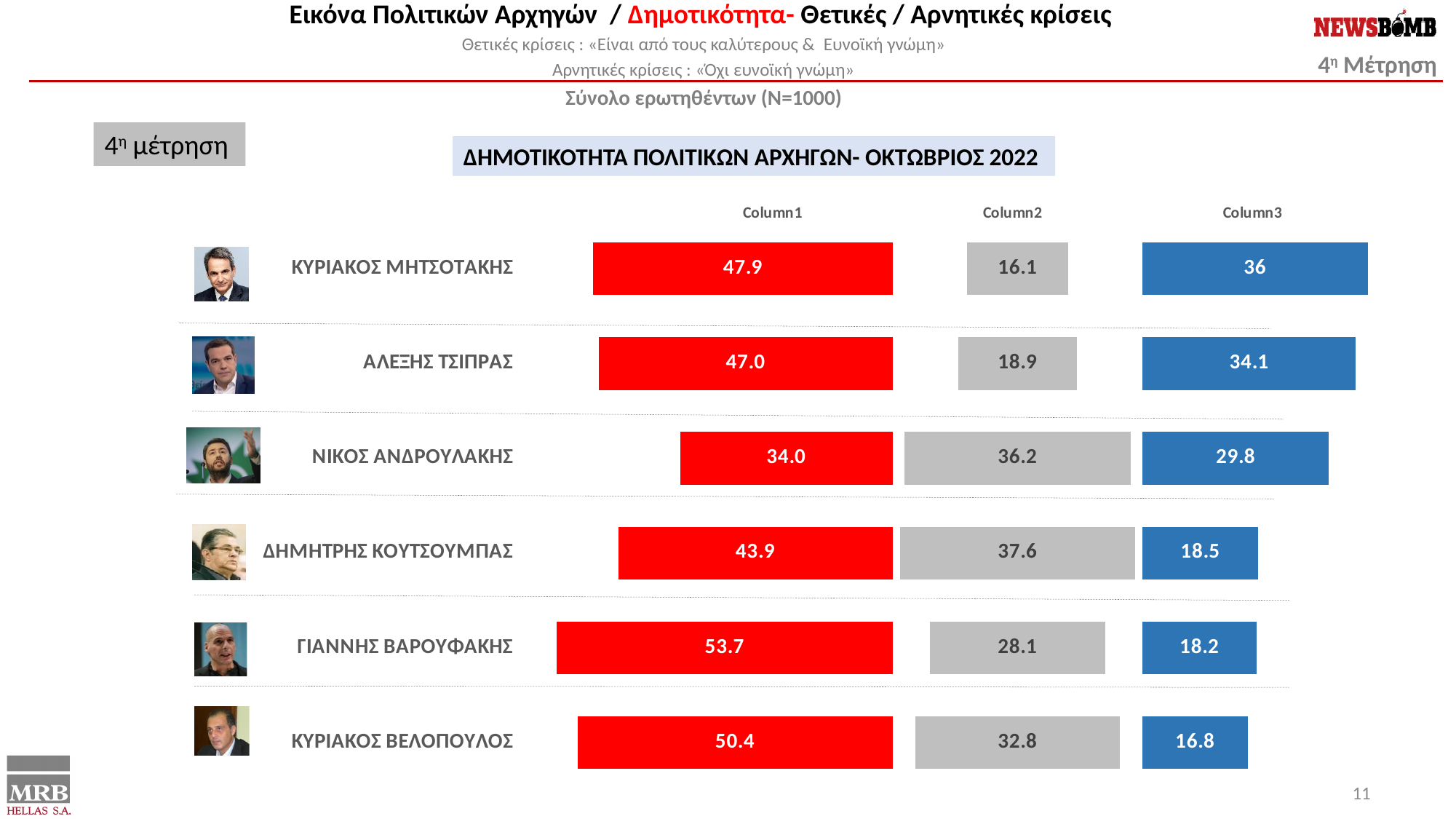
What is the Column1 value for ΚΥΡΙΑΚΟΣ ΜΗΤΣΟΤΑΚΗΣ? 47.9 How many politicians are shown in the chart? 6 What is the total of the three values for ΔΗΜΗΤΡΗΣ ΚΟΥΤΣΟΥΜΠΑΣ? 100 What kind of chart is shown on the slide? Stacked bar chart Which politician has the highest Column1 value? ΓΙΑΝΝΗΣ ΒΑΡΟΥΦΑΚΗΣ Who has the larger Column2 value, ΔΗΜΗΤΡΗΣ ΚΟΥΤΣΟΥΜΠΑΣ or ΝΙΚΟΣ ΑΝΔΡΟΥΛΑΚΗΣ? ΔΗΜΗΤΡΗΣ ΚΟΥΤΣΟΥΜΠΑΣ Which politician has the lowest Column1 value? ΝΙΚΟΣ ΑΝΔΡΟΥΛΑΚΗΣ What is the difference between the Column1 values of ΓΙΑΝΝΗΣ ΒΑΡΟΥΦΑΚΗΣ and ΚΥΡΙΑΚΟΣ ΒΕΛΟΠΟΥΛΟΣ? 3.3 Which politician has the lowest Column2 value? ΚΥΡΙΑΚΟΣ ΜΗΤΣΟΤΑΚΗΣ What is the Column3 value for ΑΛΕΞΗΣ ΤΣΙΠΡΑΣ? 34.1 How many series (columns) does the chart show? 3 What is the Column2 value for ΝΙΚΟΣ ΑΝΔΡΟΥΛΑΚΗΣ? 36.2